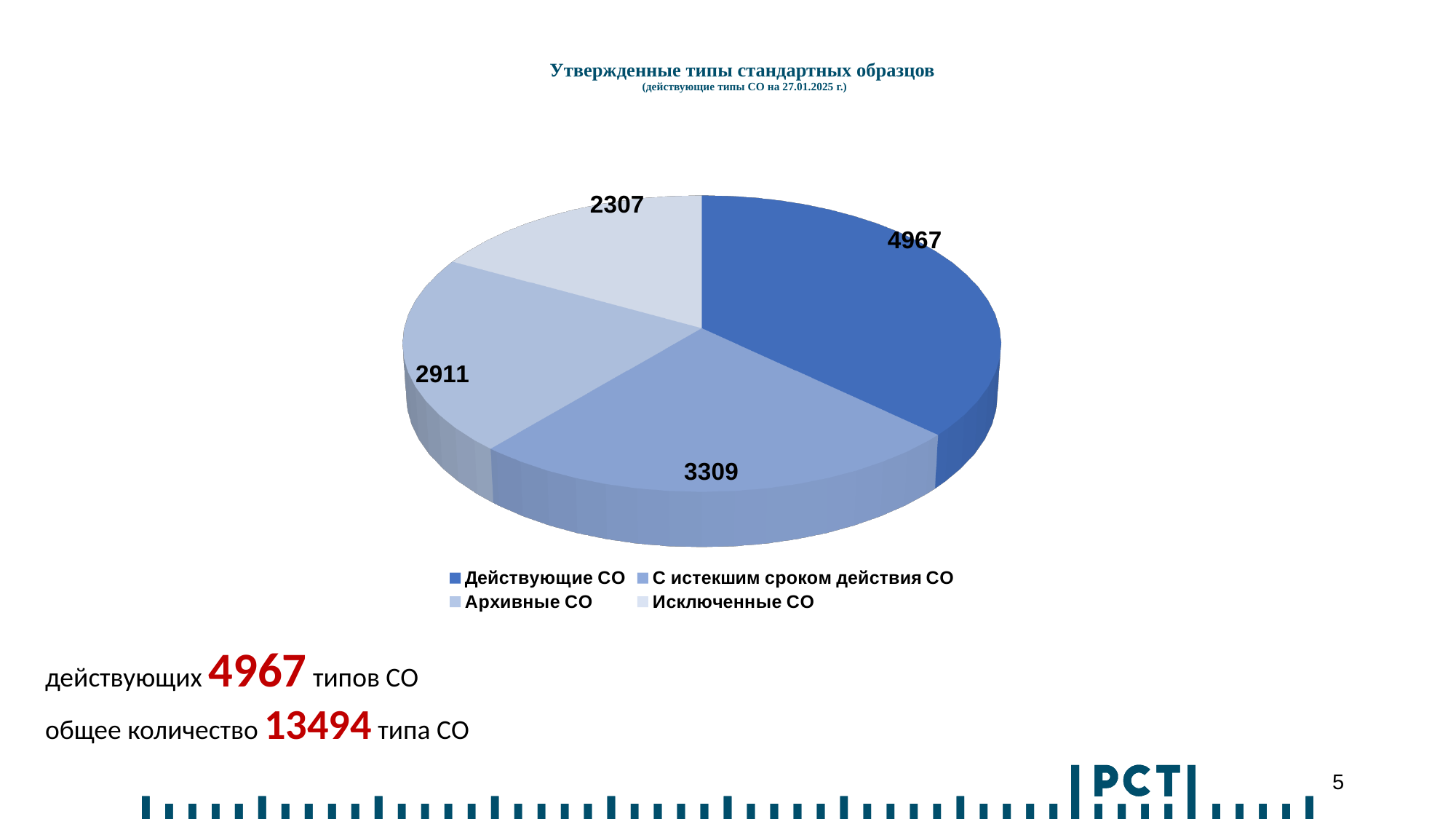
What is the value for Архивные СО? 2911 What is the title of the chart? Утвержденные типы стандартных образцов What is the total of all four slices in the pie chart? 13494 What is the value for Исключенные СО? 2307 What is the value for С истекшим сроком действия СО? 3309 Which is larger, the value for Архивные СО or the value for Исключенные СО? Архивные СО What type of chart is shown on the slide? Pie chart Which category has the smallest slice of the pie? Исключенные СО Which category has the largest slice of the pie? Действующие СО What is the value for Действующие СО? 4967 What is the difference between the values for Действующие СО and С истекшим сроком действия СО? 1658 How many slices does the pie chart have? 4